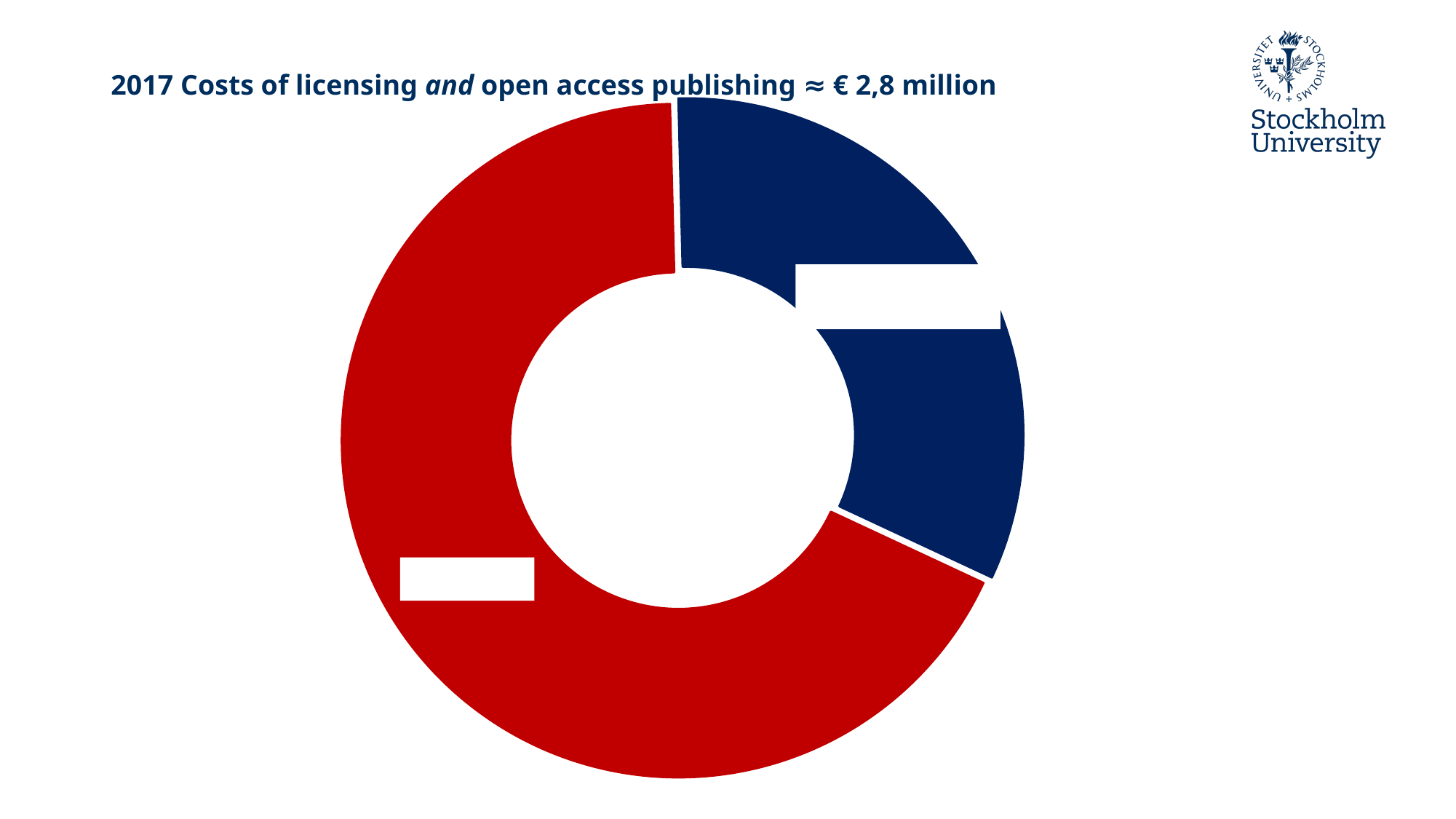
What total amount is stated in the chart title? ≈ € 2,8 million Which colour slice represents the largest share of the doughnut chart? Red Which colour slice represents the smallest share of the doughnut chart? Dark blue What is the title of the chart on the slide? 2017 Costs of licensing and open access publishing ≈ € 2,8 million Which slice of the doughnut chart is larger, the red one or the dark blue one? The red one What kind of chart is shown on the slide? Doughnut chart How many slices does the doughnut chart have? 2